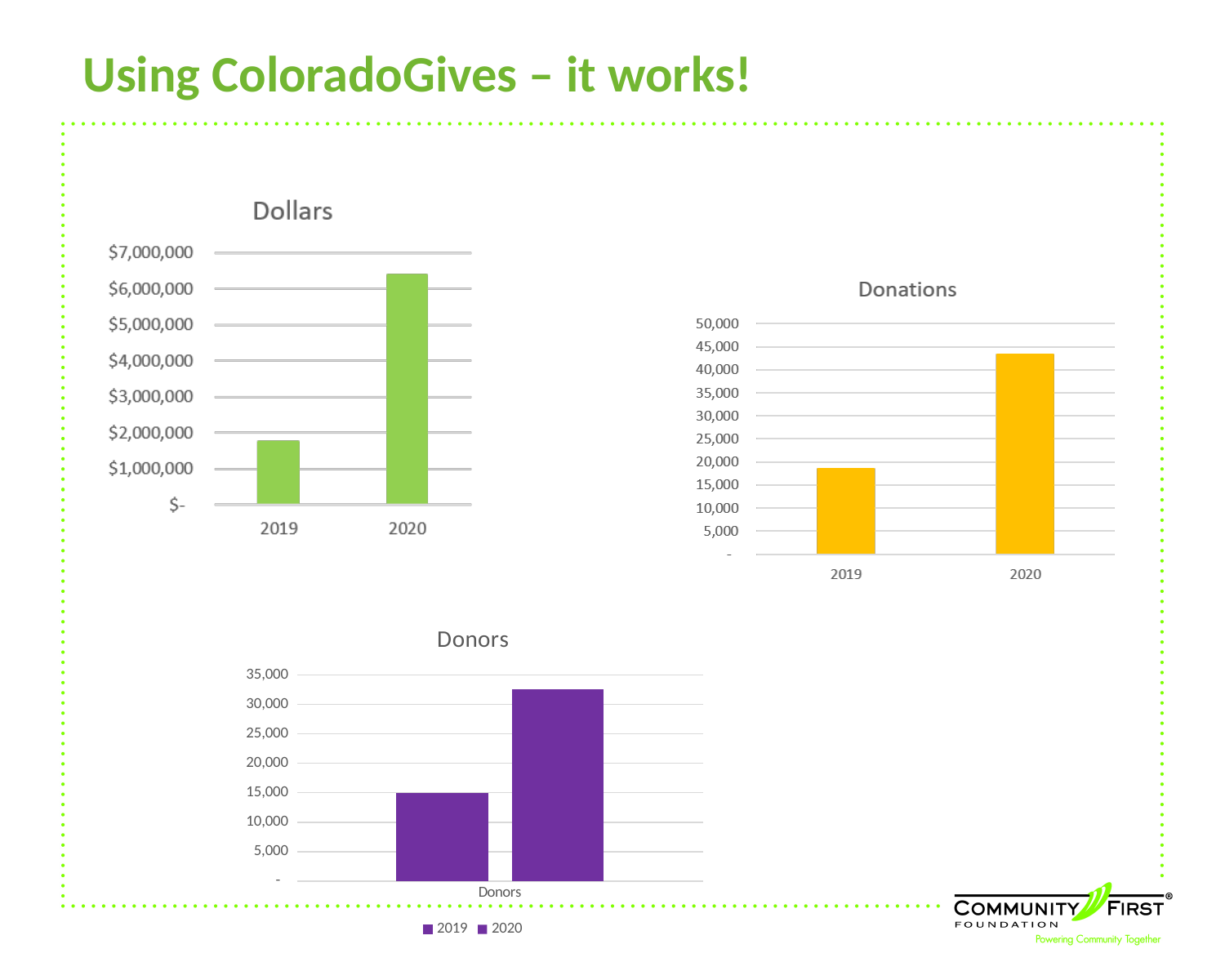
In the Donors chart, which series is larger, 2019 or 2020? 2020 How many years are shown on the x axis of the Donations chart? 2 In the Dollars chart, which year has the higher value? 2020 In the Donors chart, is the 2020 bar greater or less than 30,000? greater In the Donations chart, is the value for 2019 greater or less than 20,000? less In the Dollars chart, is the value for 2020 greater or less than $6,000,000? greater What kind of chart is the Dollars chart? bar chart In the Donations chart, which year has the lower value? 2019 How many series does the legend of the Donors chart list? 2 Do the values in the Dollars chart rise or fall from 2019 to 2020? rise